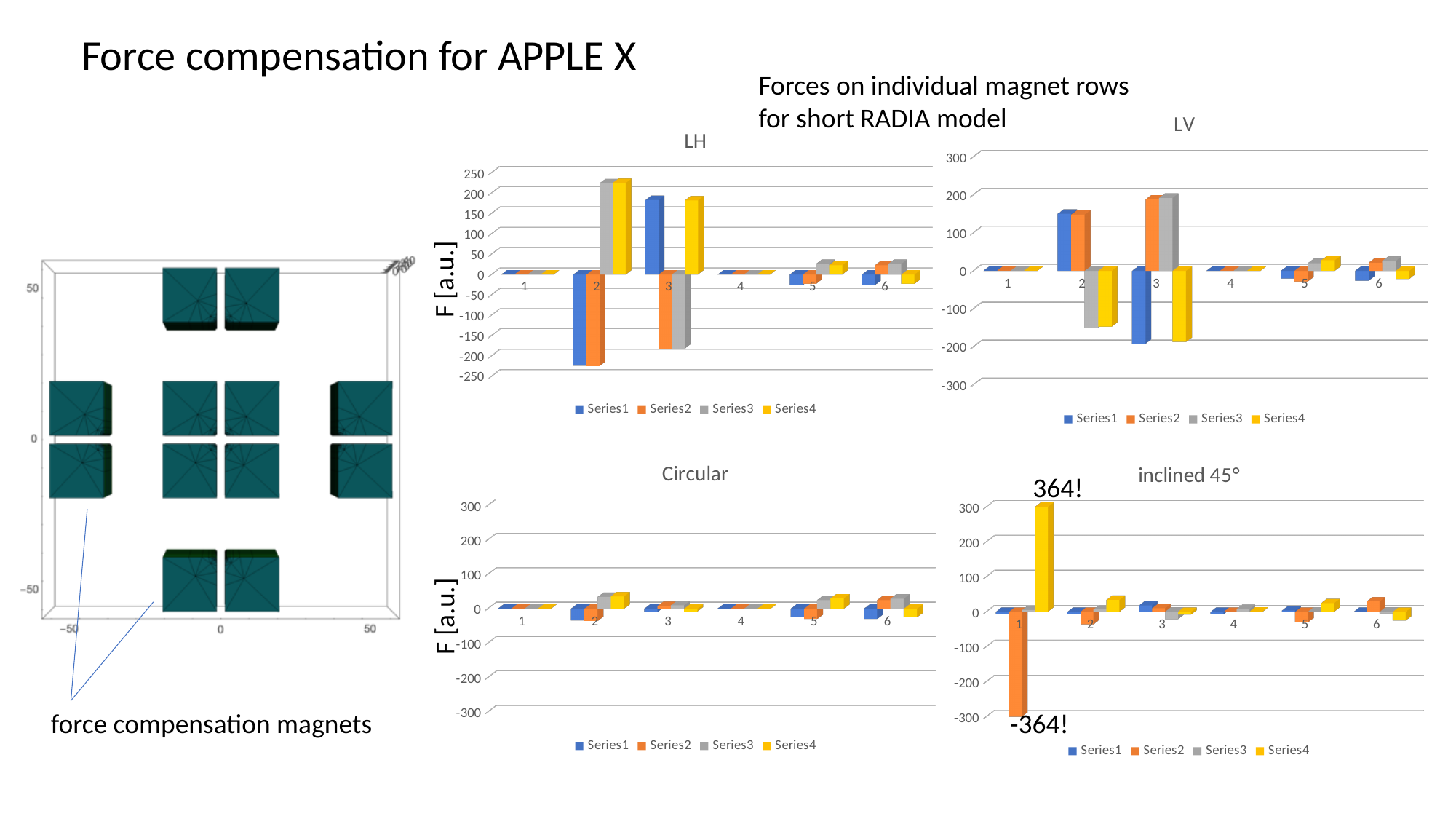
In the Circular chart, is the value for Series3 at category 2 greater or less than 100? less In the LV chart, is the value for Series1 at category 2 greater or less than 100? greater In the inclined 45° chart, what value is labelled for Series4 at category 1? 364 In the LH chart, at category 2, which is larger: Series3 or Series1? Series3 In the LH chart, is the value for Series3 at category 2 greater or less than 200? greater How many categories are shown on the x axis of the LV chart? 6 What is the y-axis label of the Circular chart? F [a.u.] How many series does the legend of the LH chart list? 4 In the inclined 45° chart, what value is labelled for Series2 at category 1? -364 What kind of chart is the LH chart? bar chart